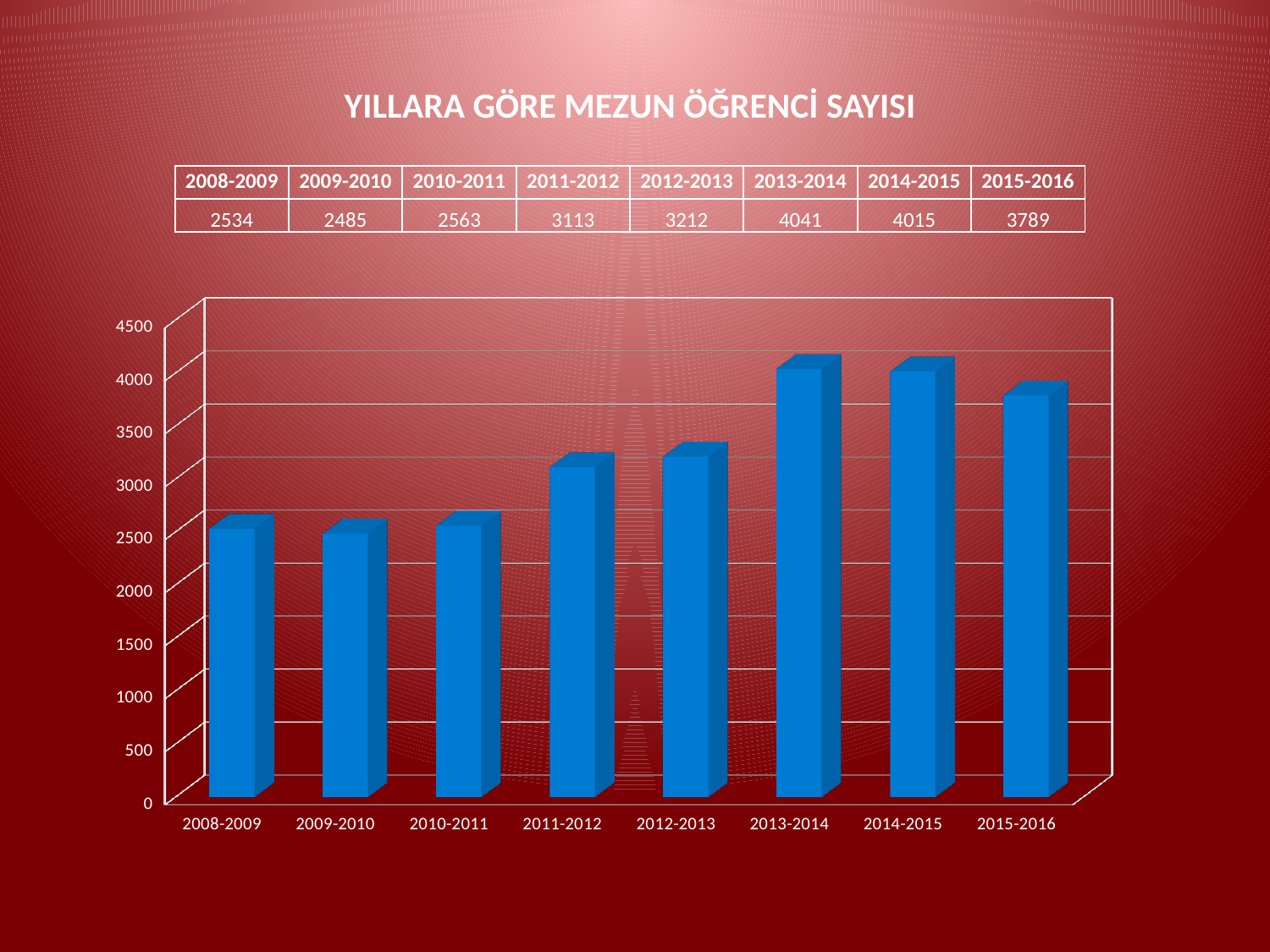
What is the difference between the number of graduates in 2012-2013 and 2011-2012? 99 Which academic year has the lowest number of graduates? 2009-2010 Is the value for 2011-2012 greater or less than 3000? greater How many academic years are shown on the chart? 8 What is the number of graduates for 2008-2009? 2534 Which academic year has the highest number of graduates? 2013-2014 Which has more graduates, 2014-2015 or 2015-2016? 2014-2015 What kind of chart is shown on the slide? bar chart What is the difference between the number of graduates in 2013-2014 and 2015-2016? 252 What is the title of the slide? YILLARA GÖRE MEZUN ÖĞRENCİ SAYISI What is the number of graduates for 2015-2016? 3789 What is the number of graduates for 2013-2014? 4041